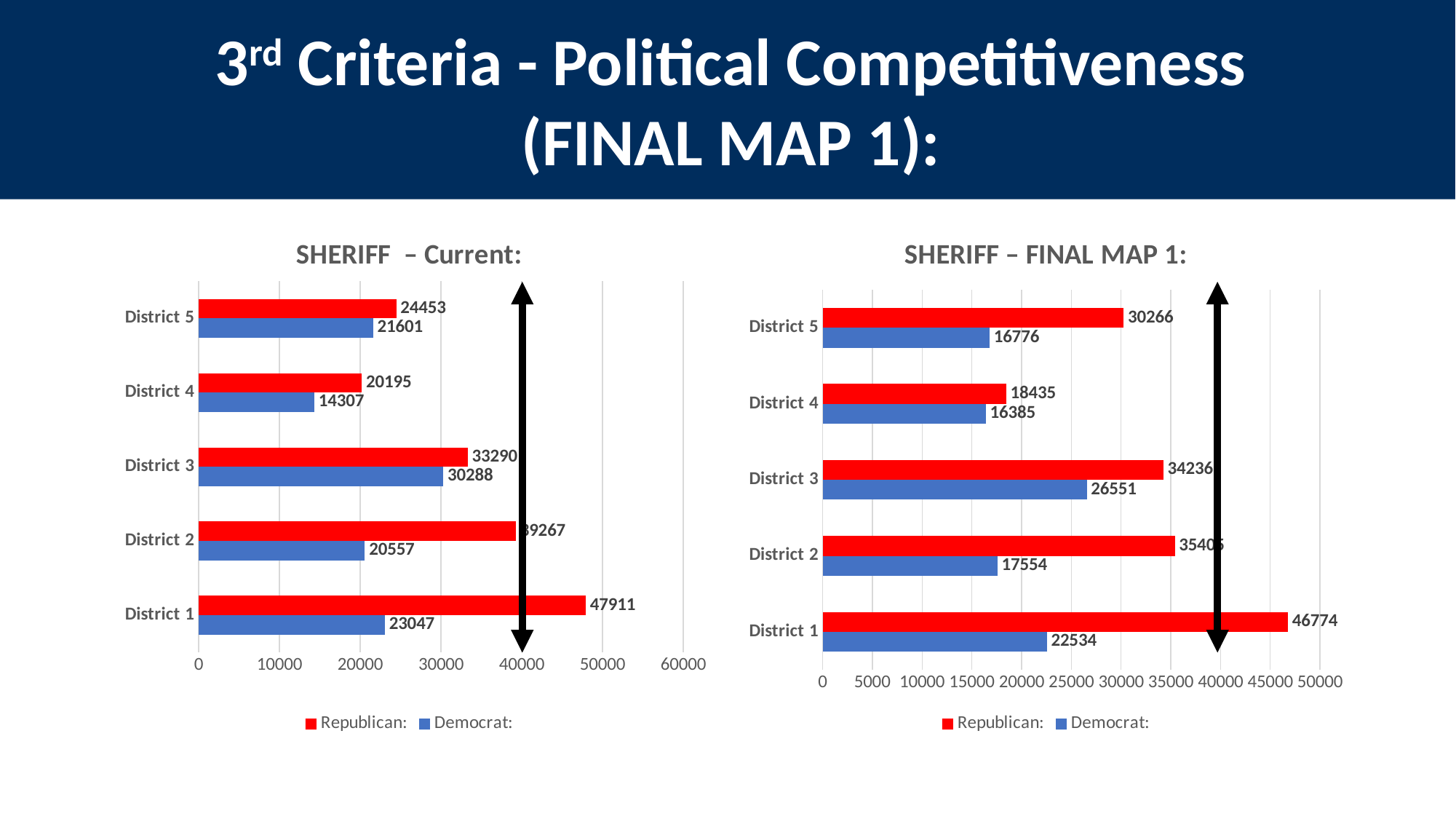
In the SHERIFF – Current chart, what is the Democrat value for District 3? 30288 In the SHERIFF – FINAL MAP 1 chart, which district has the lowest Democrat value? District 4 In the SHERIFF – FINAL MAP 1 chart, what is the Republican value for District 5? 30266 In the SHERIFF – FINAL MAP 1 chart, what is the difference between the Republican and Democrat values for District 3? 7685 In the SHERIFF – Current chart, what is the Republican value for District 1? 47911 How many districts are shown in the SHERIFF – Current chart? 5 In the SHERIFF – FINAL MAP 1 chart, what is the Democrat value for District 4? 16385 In the SHERIFF – FINAL MAP 1 chart, which is larger for District 1, the Republican value or the Democrat value? Republican In the SHERIFF – Current chart, what is the difference between the Republican and Democrat values for District 5? 2852 How many series does the legend of the SHERIFF – FINAL MAP 1 chart list? 2 What type of chart is the SHERIFF – Current chart? Bar chart In the SHERIFF – Current chart, which district has the highest Republican value? District 1